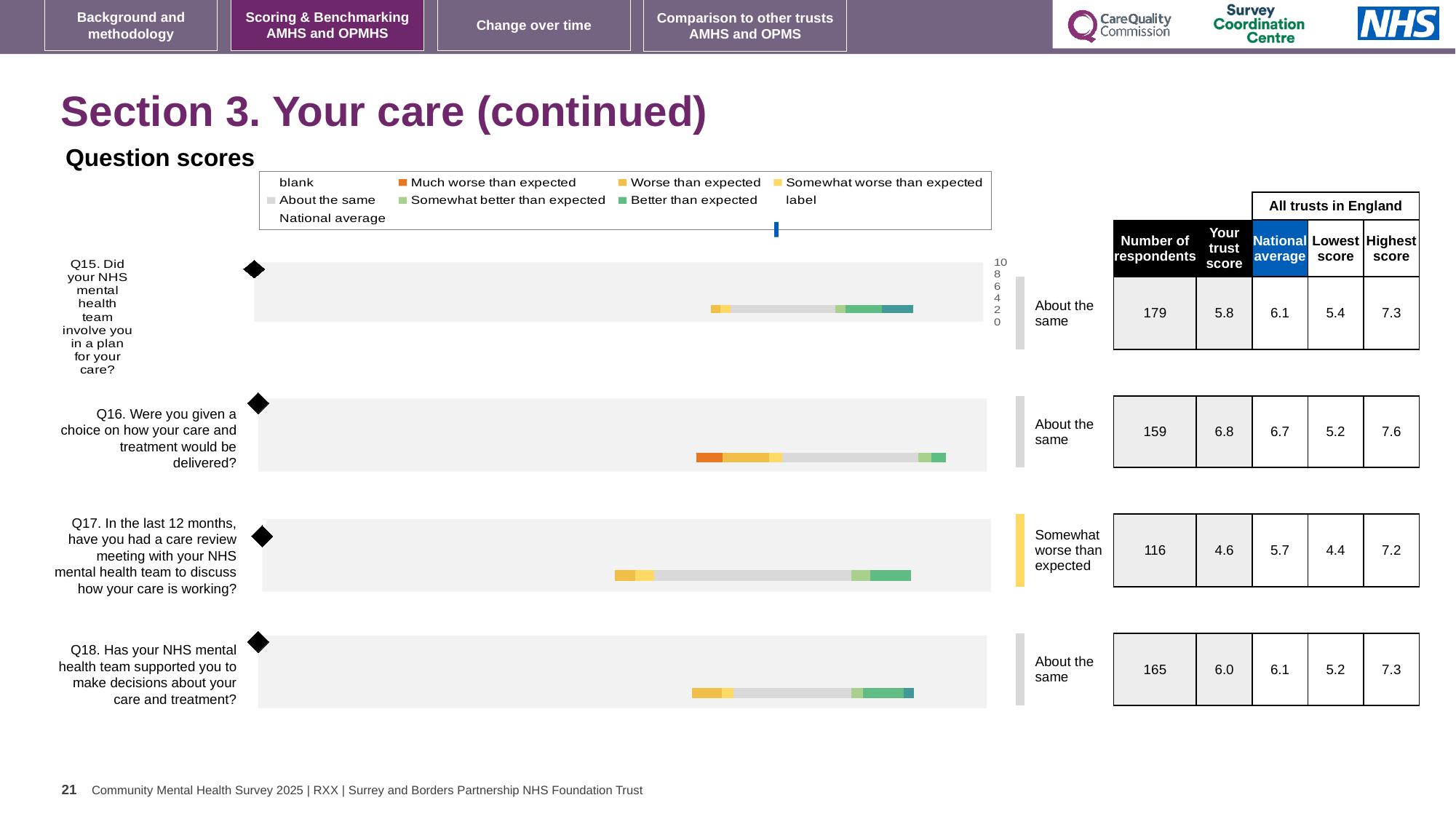
What is the national average score for Q18 (supported you to make decisions about your care and treatment)? 6.1 What is the trust score for Q16 (Were you given a choice on how your care and treatment would be delivered)? 6.8 What is the lowest score across all trusts in England for Q17? 4.4 By how much does the national average exceed the trust score for Q17? 1.1 Which question has the lowest trust score on this slide? Q17 How many respondents answered Q17 (care review meeting in the last 12 months)? 116 How many questions (Q15 to Q18) have a score bar plotted on the slide? 4 Which question has the highest trust score on this slide? Q16 What kind of chart is used to show the question scores for Q15 to Q18? bar chart What benchmark label is shown next to the bar for Q17? Somewhat worse than expected What is the highest score across all trusts in England for Q16? 7.6 For Q15, which is larger: the trust score or the national average? National average